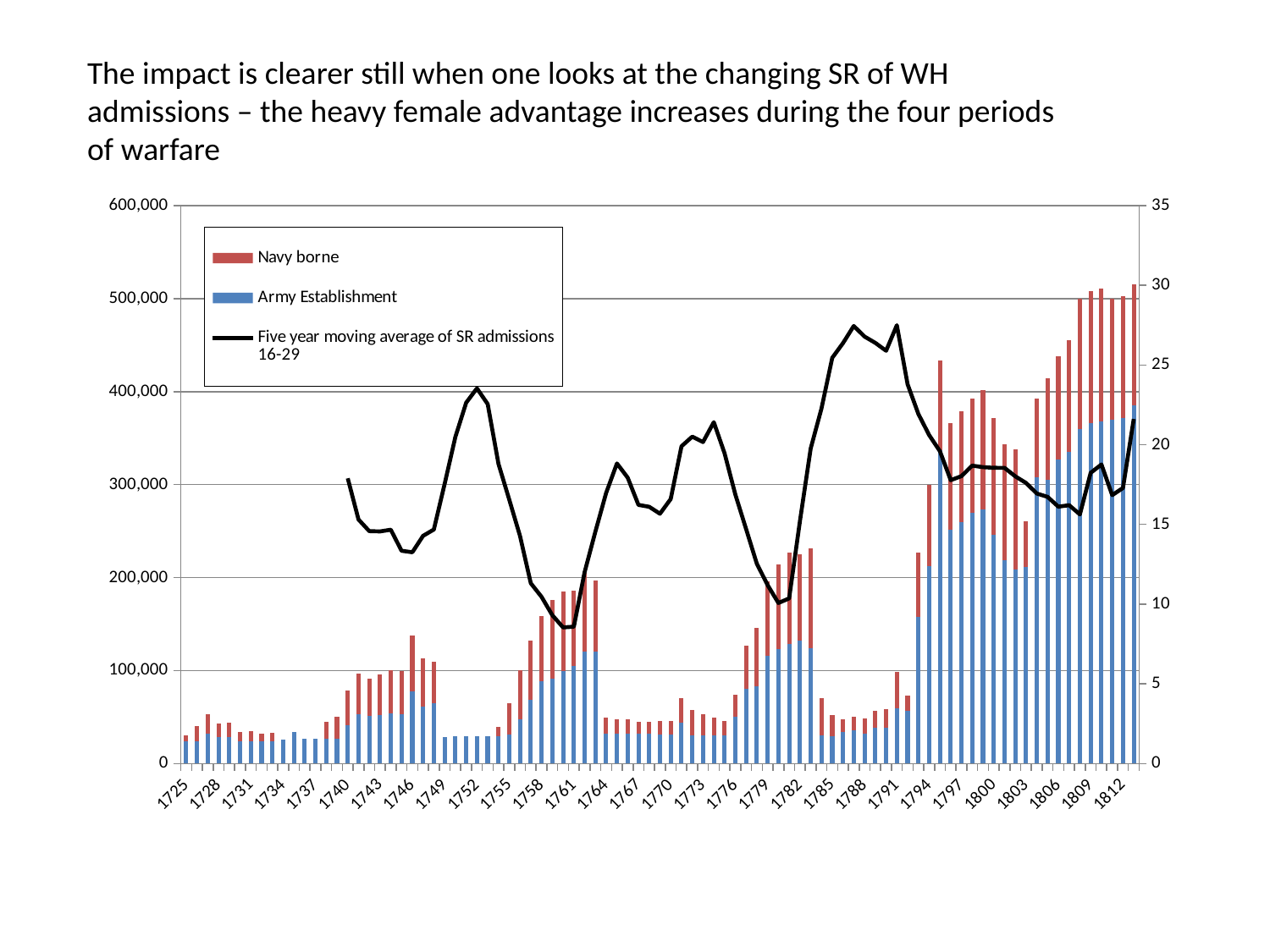
Which year has the larger total stacked bar, 1767 or 1782? 1782 What colour are the Navy borne bars? Red Is the five year moving average line value for 1788 greater or less than 25? greater Is the total stacked bar value for 1812 greater or less than 400,000? greater Is the total stacked bar value for 1782 greater or less than 200,000? greater What kind of chart is this? A stacked bar chart combined with a line How many series does the legend list? 3 Which series is drawn as a black line? Five year moving average of SR admissions 16-29 Do the stacked bar totals generally rise or fall from 1794 to 1812? rise